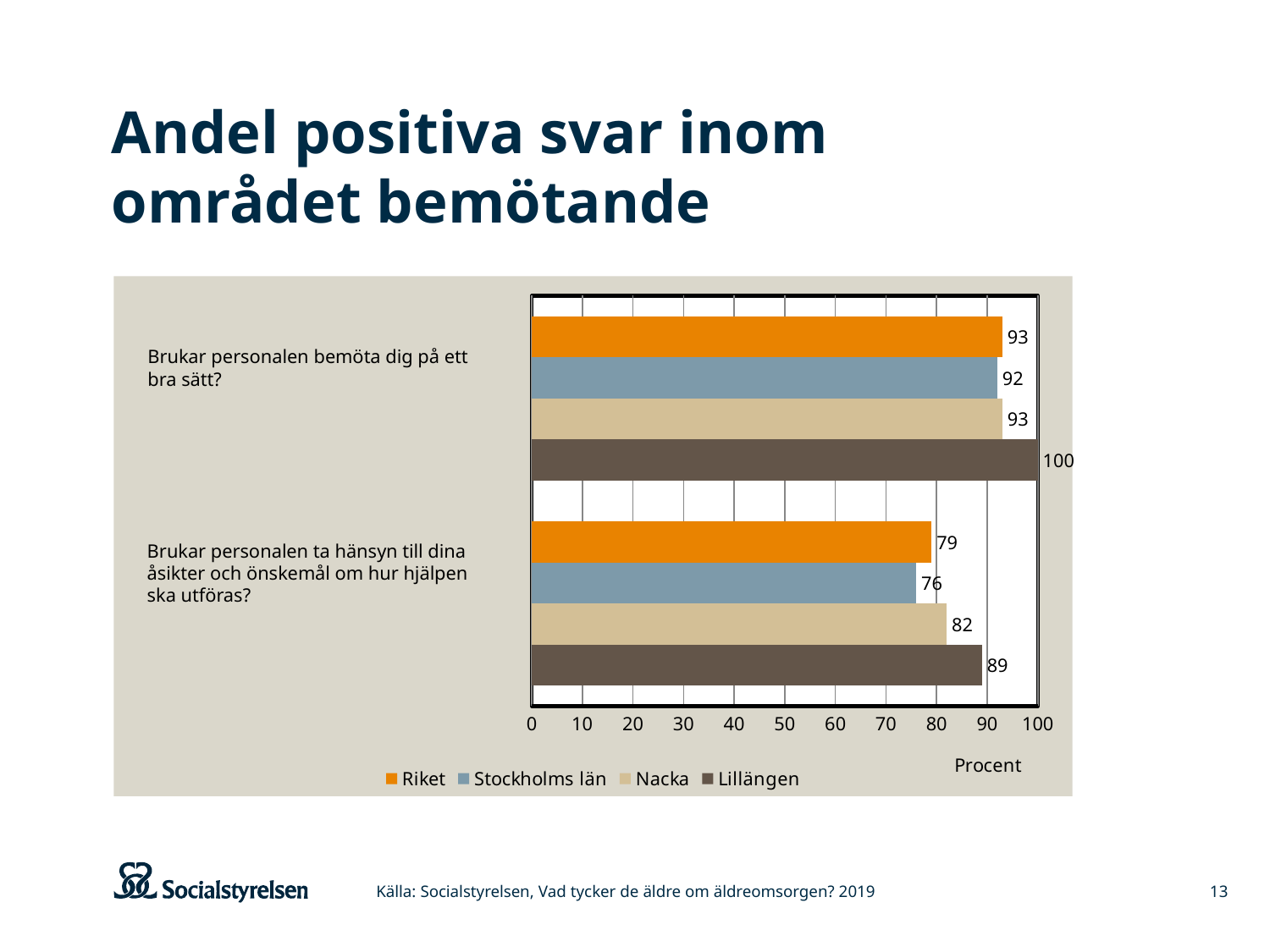
What is the value for Lillängen on the question "Brukar personalen bemöta dig på ett bra sätt?"? 100 What is the value for Stockholms län on the question "Brukar personalen ta hänsyn till dina åsikter och önskemål om hur hjälpen ska utföras?"? 76 Which series has the highest value on the question "Brukar personalen ta hänsyn till dina åsikter och önskemål om hur hjälpen ska utföras?"? Lillängen How many series does the legend list? 4 What is the difference between the Lillängen and Riket values on the question "Brukar personalen ta hänsyn till dina åsikter och önskemål om hur hjälpen ska utföras?"? 10 What is the value for Nacka on the question "Brukar personalen ta hänsyn till dina åsikter och önskemål om hur hjälpen ska utföras?"? 82 Which series has the lowest value on the question "Brukar personalen ta hänsyn till dina åsikter och önskemål om hur hjälpen ska utföras?"? Stockholms län What kind of chart is shown on the slide? Bar chart What is the label of the horizontal axis? Procent What is the difference between the Lillängen and Stockholms län values on the question "Brukar personalen bemöta dig på ett bra sätt?"? 8 Which is larger: the Nacka value or the Stockholms län value on the question "Brukar personalen ta hänsyn till dina åsikter och önskemål om hur hjälpen ska utföras?"? Nacka What is the value for Riket on the question "Brukar personalen bemöta dig på ett bra sätt?"? 93